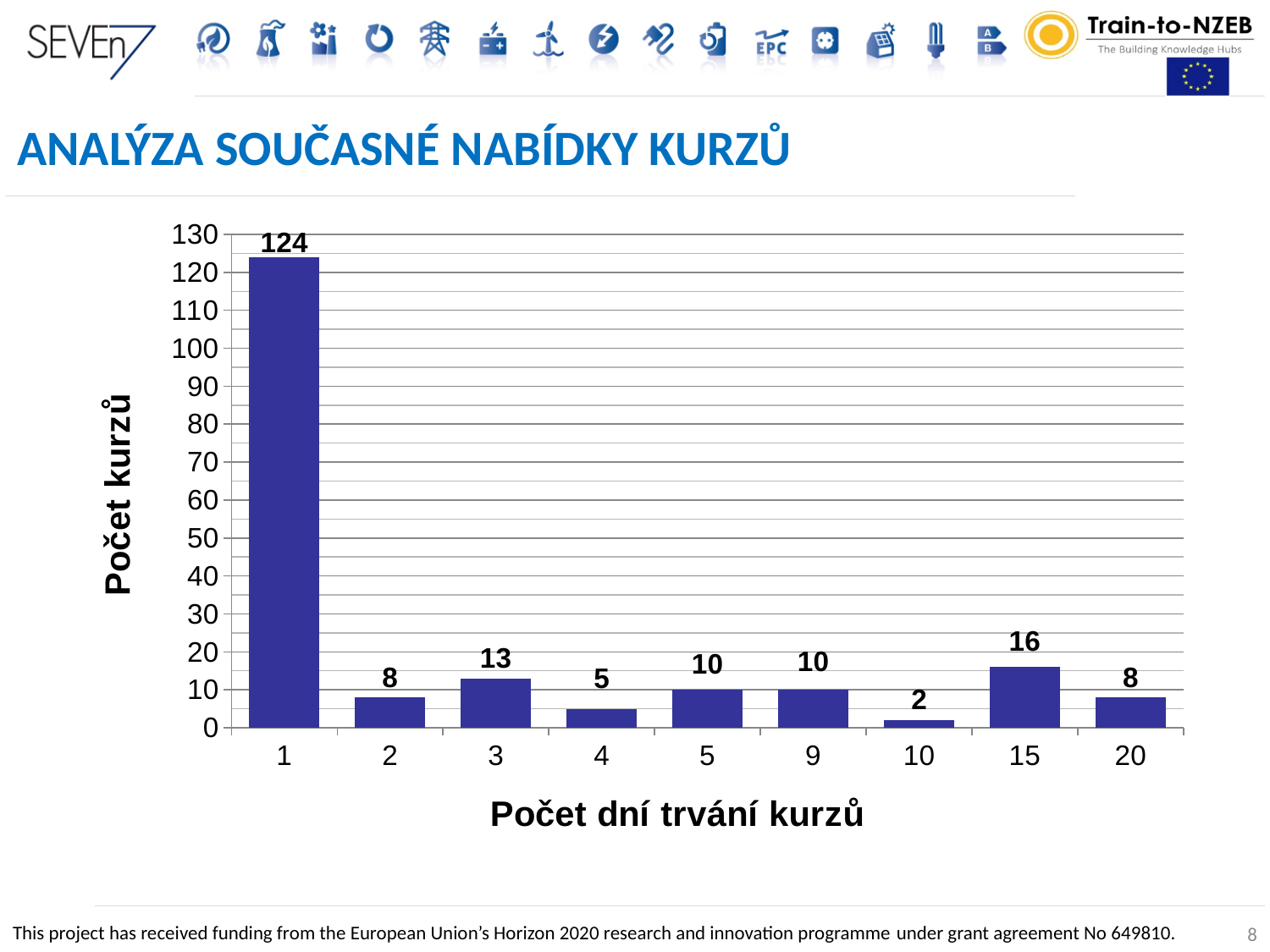
How many courses last 10 days? 2 What is the combined number of courses lasting 5 days and 9 days? 20 What is the label of the x axis? Počet dní trvání kurzů Which course duration (in days) has the lowest number of courses? 10 Which has more courses: a duration of 3 days or a duration of 4 days? 3 days What type of chart is shown on the slide? Bar chart What is the label of the y axis? Počet kurzů How many course duration categories are shown on the x axis? 9 How many courses last 1 day according to the chart? 124 Which course duration (in days) has the highest number of courses? 1 What is the number of courses with a duration of 15 days? 16 What is the difference between the number of 1-day courses and the number of 15-day courses? 108